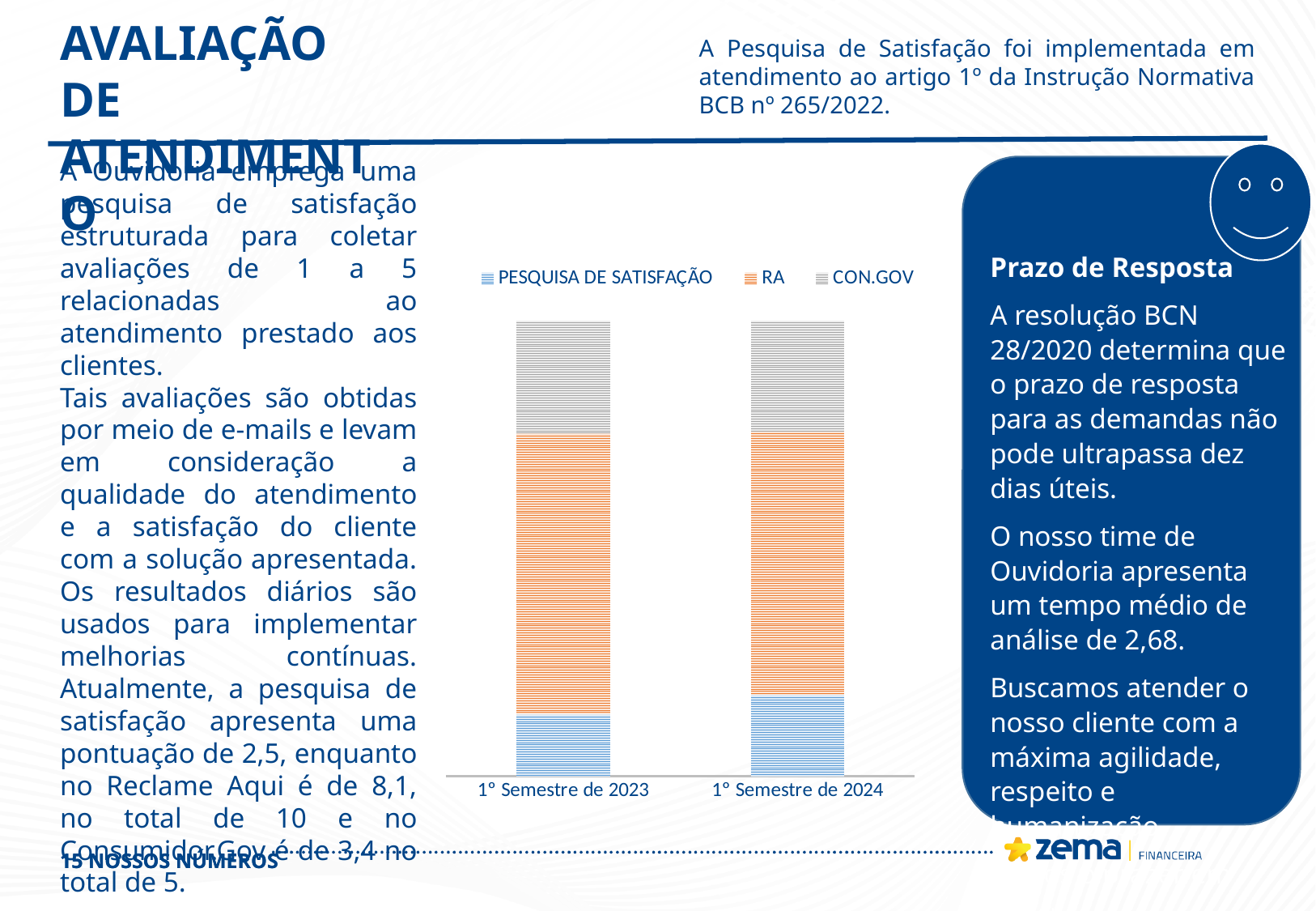
What kind of chart is shown on the slide? Stacked bar chart How many categories are shown on the x axis of the chart? 2 Which series is shown in orange in the chart? RA Is the PESQUISA DE SATISFAÇÃO segment larger in 1° Semestre de 2023 or in 1° Semestre de 2024? 1° Semestre de 2024 Does the PESQUISA DE SATISFAÇÃO segment rise or fall from 1° Semestre de 2023 to 1° Semestre de 2024? Rise What are the series names listed in the chart legend? PESQUISA DE SATISFAÇÃO, RA, CON.GOV What are the two category labels on the x axis of the chart? 1° Semestre de 2023, 1° Semestre de 2024 How many series does the chart legend list? 3 In the bar for 1° Semestre de 2023, which series occupies the smallest segment? PESQUISA DE SATISFAÇÃO In the bar for 1° Semestre de 2024, which series occupies the largest segment? RA In the bar for 1° Semestre de 2023, which series occupies the largest segment? RA